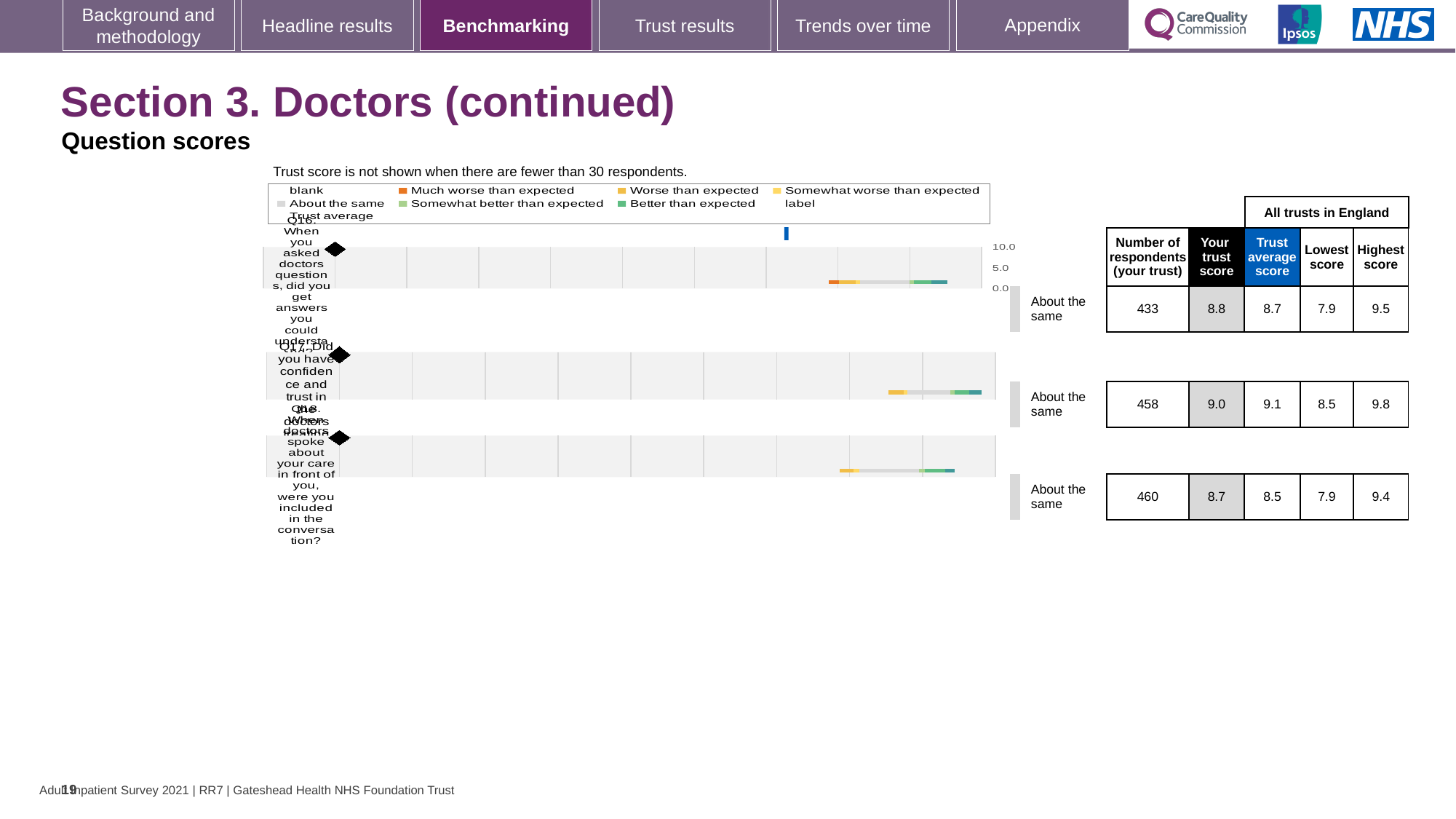
What is the trust average score for Q18? 8.5 What is the highest score across all trusts in England for Q16? 9.5 Which question has the highest trust score? Q17 What is the trust score for Q17 (confidence and trust in the doctors)? 9.0 How many questions are plotted on the chart? 3 For Q16, which is larger: the trust score or the trust average score? the trust score (8.8) Which question has the lowest trust score? Q18 What benchmark category is shown for all three questions on the chart? About the same What is the difference between the highest score and the lowest score for Q17? 1.3 Is the trust score for Q17 greater or less than 5.0? greater How many respondents answered Q16 for this trust? 433 What kind of chart is shown on the slide? bar chart